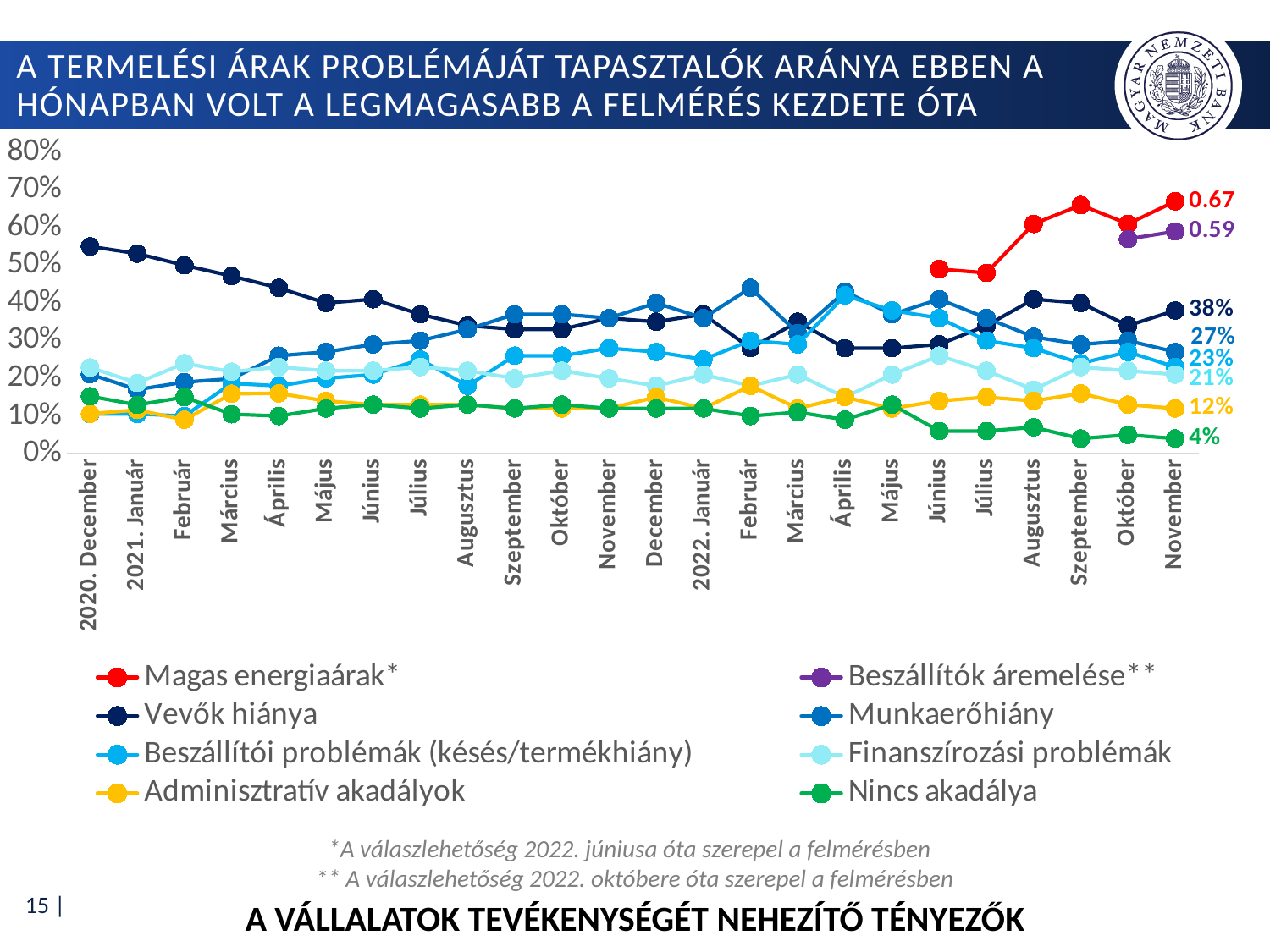
Which series has the lowest value in November 2022? Nincs akadálya What is the value for Adminisztratív akadályok in November 2022? 12% What is the value for Beszállítók áremelése in November 2022? 0.59 What is the value for Magas energiaárak in November 2022? 0.67 What type of chart is shown on the slide? line chart What is the value for Nincs akadálya in November 2022? 4% Does the Vevők hiánya series rise or fall from 2020. December to 2021. Július? fall What is the difference between Munkaerőhiány and Beszállítói problémák in November 2022? 4 percentage points How many series does the legend list? 8 Is the value for Vevők hiánya in 2020. December greater or less than 50%? greater Which series has the highest value in November 2022? Magas energiaárak What is the value for Vevők hiánya in November 2022? 38%